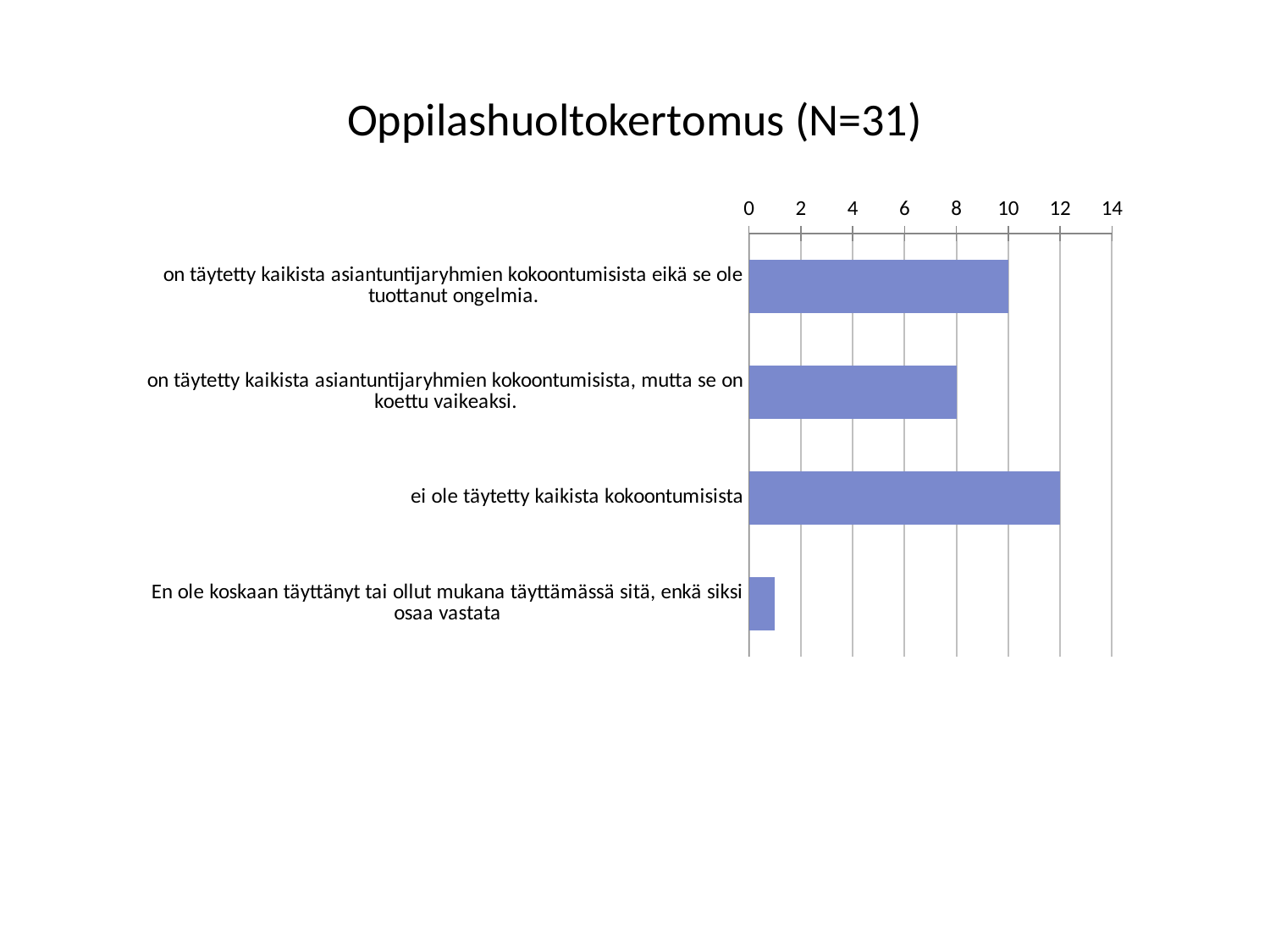
What is the title of the chart? Oppilashuoltokertomus (N=31) What kind of chart is shown on the slide? bar chart Which category has the lowest value? En ole koskaan täyttänyt tai ollut mukana täyttämässä sitä, enkä siksi osaa vastata What is the value for "on täytetty kaikista asiantuntijaryhmien kokoontumisista eikä se ole tuottanut ongelmia."? 10 Which is larger: the value for "on täytetty kaikista asiantuntijaryhmien kokoontumisista eikä se ole tuottanut ongelmia." or the value for "on täytetty kaikista asiantuntijaryhmien kokoontumisista, mutta se on koettu vaikeaksi."? on täytetty kaikista asiantuntijaryhmien kokoontumisista eikä se ole tuottanut ongelmia. Which category has the highest value? ei ole täytetty kaikista kokoontumisista What is the difference between the values for "ei ole täytetty kaikista kokoontumisista" and "on täytetty kaikista asiantuntijaryhmien kokoontumisista, mutta se on koettu vaikeaksi."? 4 What is the value for "on täytetty kaikista asiantuntijaryhmien kokoontumisista, mutta se on koettu vaikeaksi."? 8 Is the value for "En ole koskaan täyttänyt tai ollut mukana täyttämässä sitä, enkä siksi osaa vastata" greater or less than 2? less How many categories does the chart show? 4 What is the value for "ei ole täytetty kaikista kokoontumisista"? 12 What is the maximum value shown on the value axis? 14